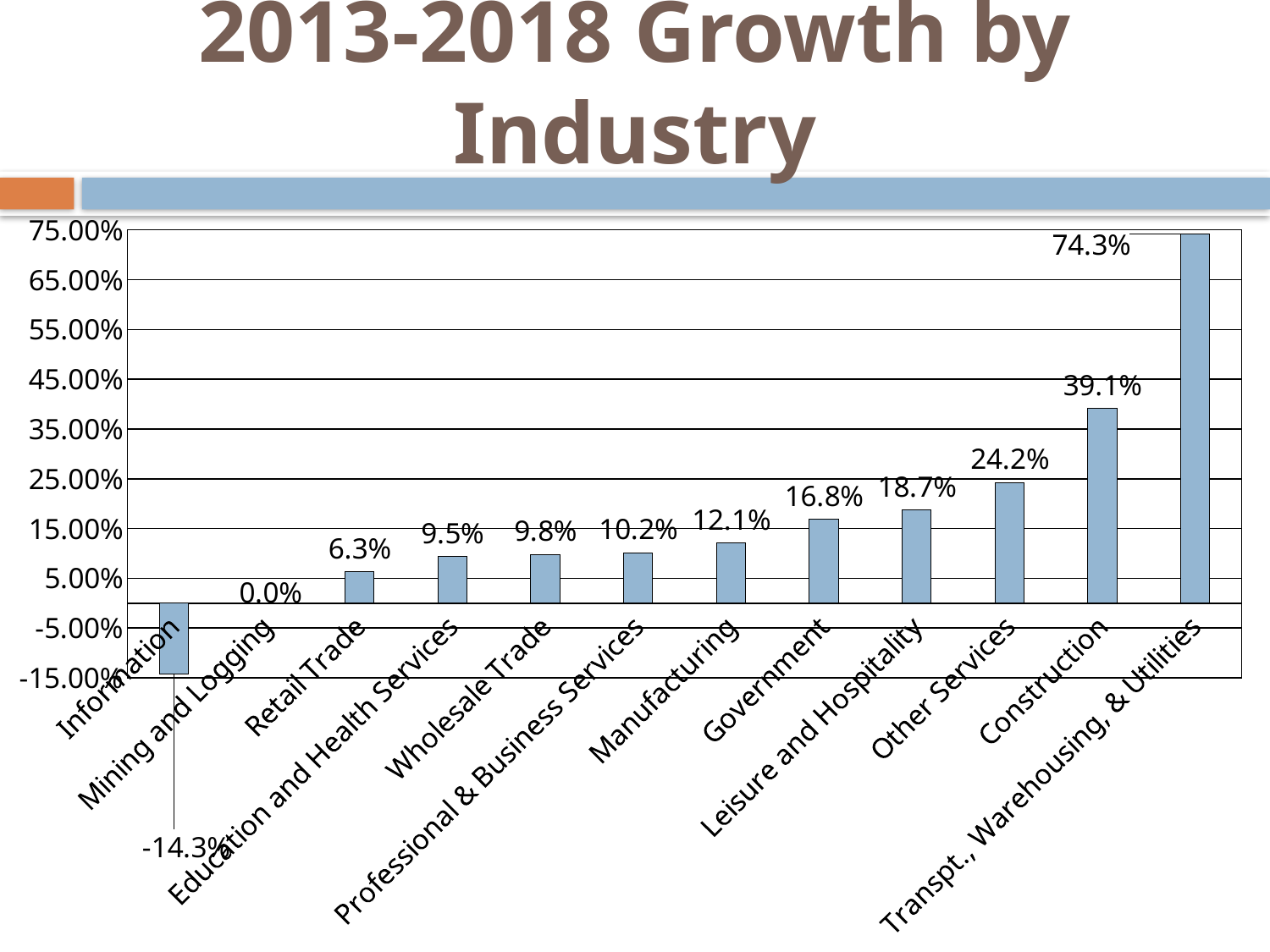
How many industries are shown on the chart? 12 Which has a higher growth value, Manufacturing or Retail Trade? Manufacturing What is the growth value shown for Government? 16.8% What kind of chart is shown on the slide? Bar chart What is the growth value shown for Information? -14.3% What is the difference between the growth values for Construction and Other Services? 14.9% Which industry has the lowest growth? Information Do the growth values rise or fall moving from left to right along the x axis? Rise What is the title of the chart on the slide? 2013-2018 Growth by Industry What is the 2013-2018 growth value for Construction? 39.1% Which industry has the highest growth? Transpt., Warehousing, & Utilities What is the growth value shown for Mining and Logging? 0.0%